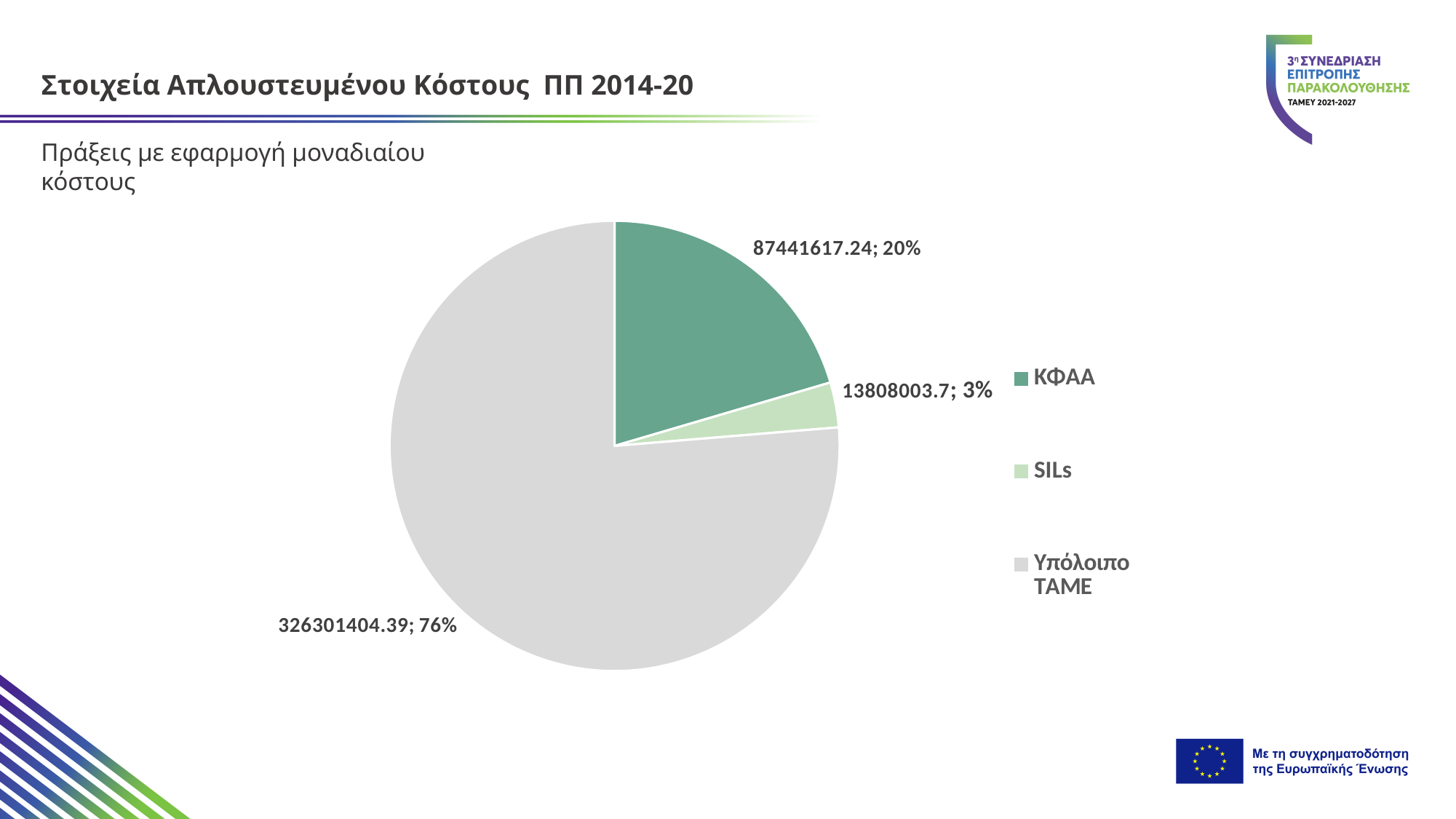
What share of the pie does ΚΦΑΑ represent? 20% How many slices does the pie chart have? 3 What share of the pie does Υπόλοιπο ΤΑΜΕ represent? 76% What is the value shown for Υπόλοιπο ΤΑΜΕ in the pie chart? 326301404.39 Which slice of the pie chart is the largest? Υπόλοιπο ΤΑΜΕ What share of the pie does SILs represent? 3% Which slice of the pie chart is the smallest? SILs What is the value shown for SILs in the pie chart? 13808003.7 Which is larger, the value for ΚΦΑΑ or the value for SILs? ΚΦΑΑ What is the value shown for ΚΦΑΑ in the pie chart? 87441617.24 What is the title of the pie chart? Πράξεις με εφαρμογή μοναδιαίου κόστους What kind of chart is shown on the slide? pie chart